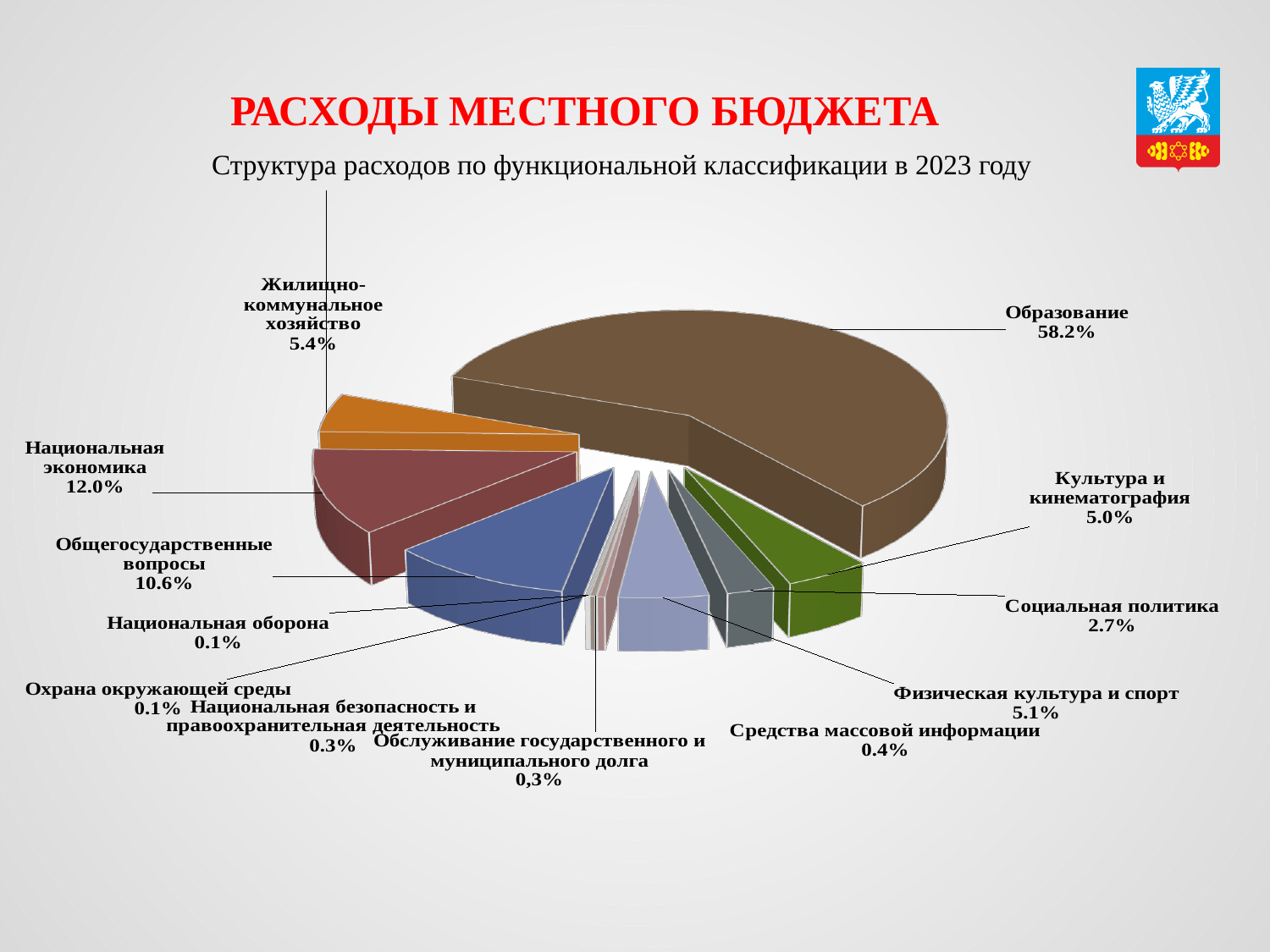
What share of expenditures goes to Образование? 58.2% What kind of chart is shown on the slide? pie chart What is the difference in percentage points between Национальная экономика and Общегосударственные вопросы? 1.4 What share of expenditures goes to Национальная экономика? 12.0% What share of expenditures goes to Социальная политика? 2.7% Which category has the largest share of expenditures? Образование What share of expenditures goes to Жилищно-коммунальное хозяйство? 5.4% How many categories are shown in the pie chart? 12 What year does the chart subtitle refer to? 2023 What is the difference in percentage points between Образование and Национальная экономика? 46.2 Which is larger: the share for Физическая культура и спорт or the share for Культура и кинематография? Физическая культура и спорт What share of expenditures goes to Общегосударственные вопросы? 10.6%